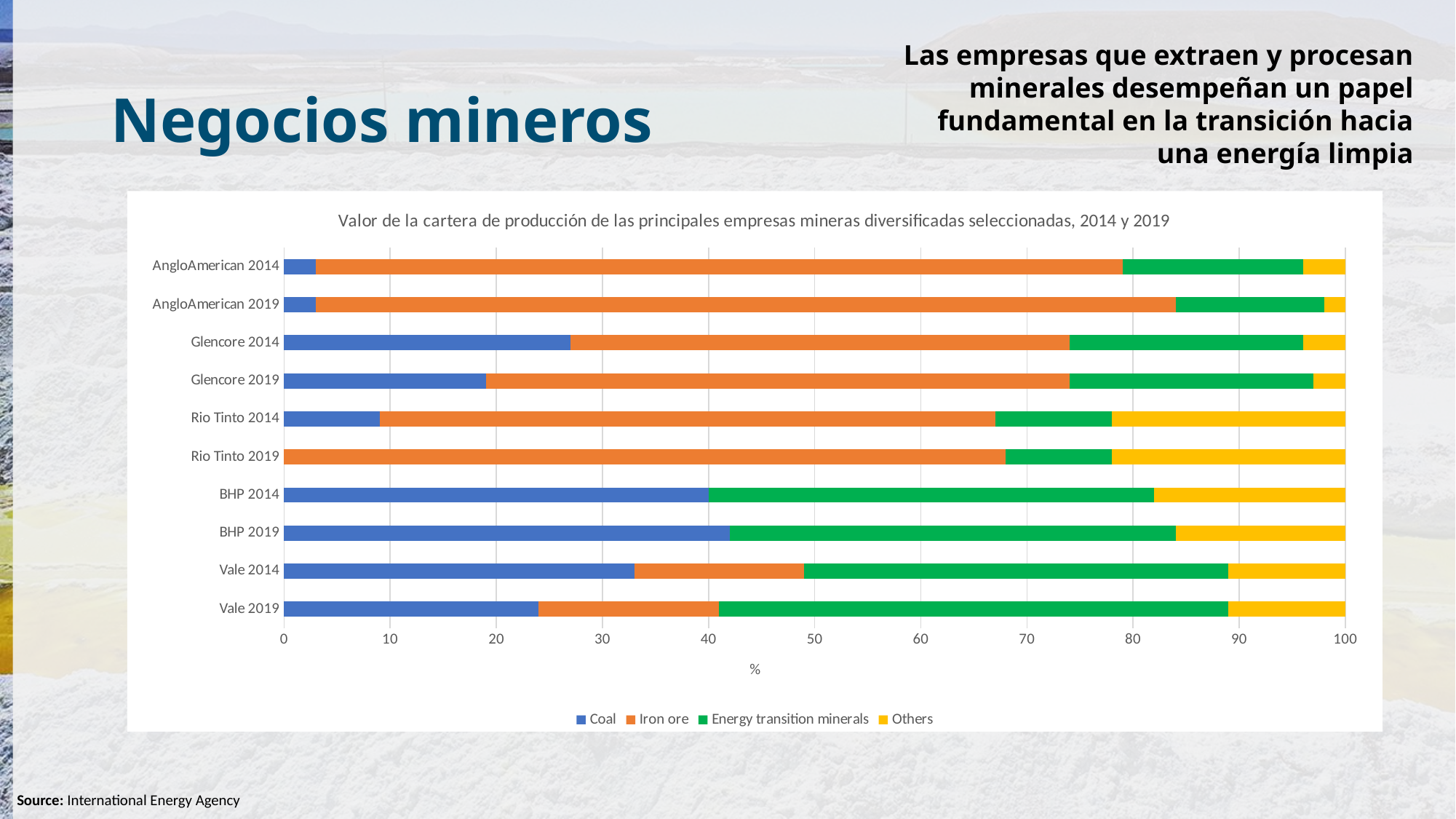
Which category has the largest Iron ore segment? AngloAmerican 2019 What unit is shown on the horizontal axis of the chart? % What kind of chart is shown on the slide? Stacked bar chart Is the Coal value for BHP 2014 greater or less than 30? greater How many series does the chart legend list? 4 Which has the larger Coal segment, Glencore 2014 or Glencore 2019? Glencore 2014 What are the four series listed in the chart legend? Coal, Iron ore, Energy transition minerals, Others Is the Coal value for Glencore 2014 greater or less than 20? greater Which has the larger Coal segment, BHP 2014 or Vale 2014? BHP 2014 How many company-year categories are plotted on the chart? 10 Is the Coal value for AngloAmerican 2019 greater or less than 10? less